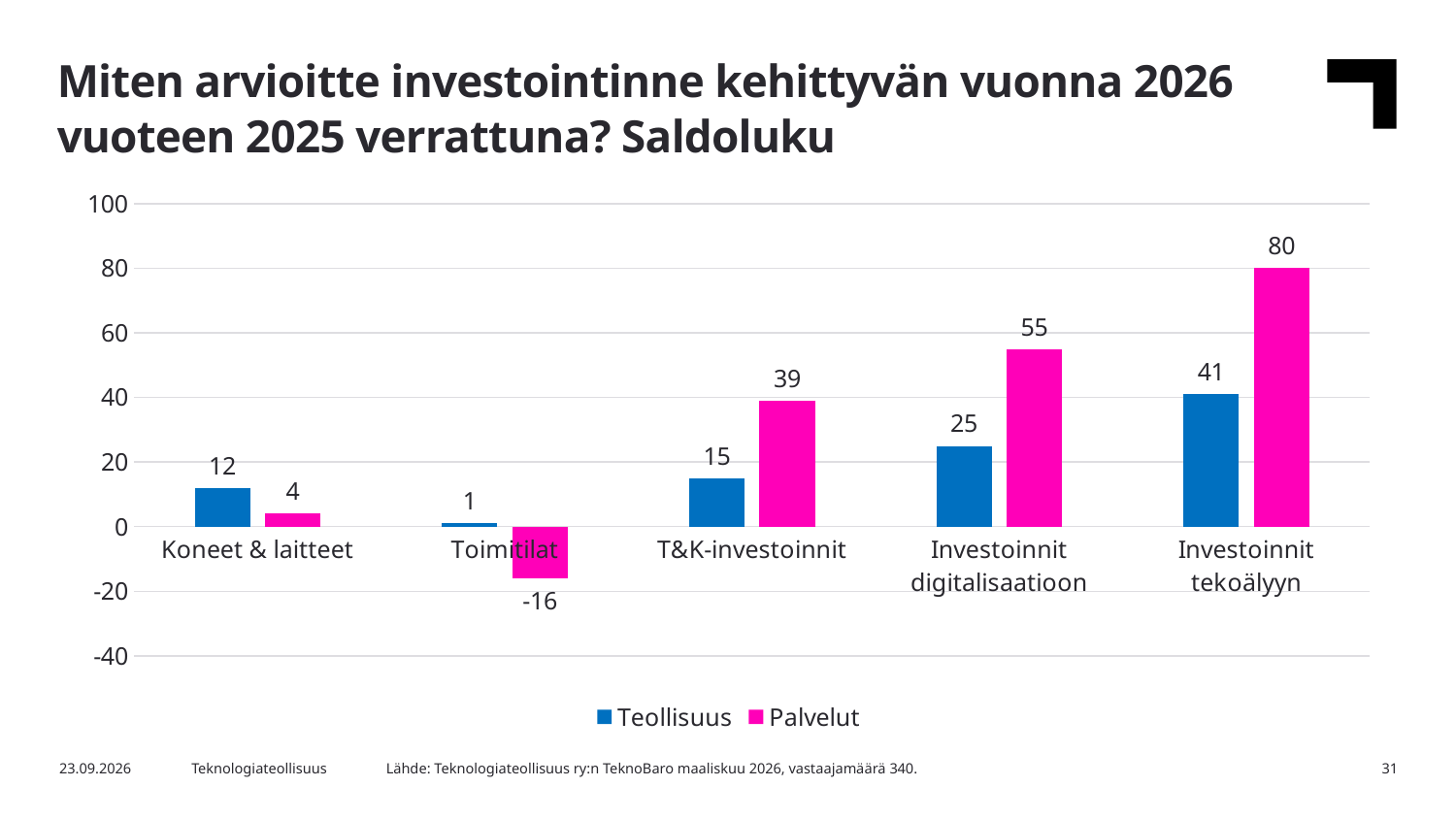
Which category has the lowest Teollisuus value? Toimitilat What is the Palvelut value for Investoinnit tekoälyyn? 80 How many series does the legend list? 2 Which category has the highest Palvelut value? Investoinnit tekoälyyn What is the Palvelut value for Toimitilat? -16 What is the Teollisuus value for Investoinnit digitalisaatioon? 25 What is the Teollisuus value for Koneet & laitteet? 12 Which is larger for Koneet & laitteet, the Teollisuus value or the Palvelut value? Teollisuus How many categories are shown on the x axis? 5 Which colour represents the Palvelut series? Magenta (pink) What is the difference between the Palvelut and Teollisuus values for T&K-investoinnit? 24 What kind of chart is shown on the slide? Bar chart